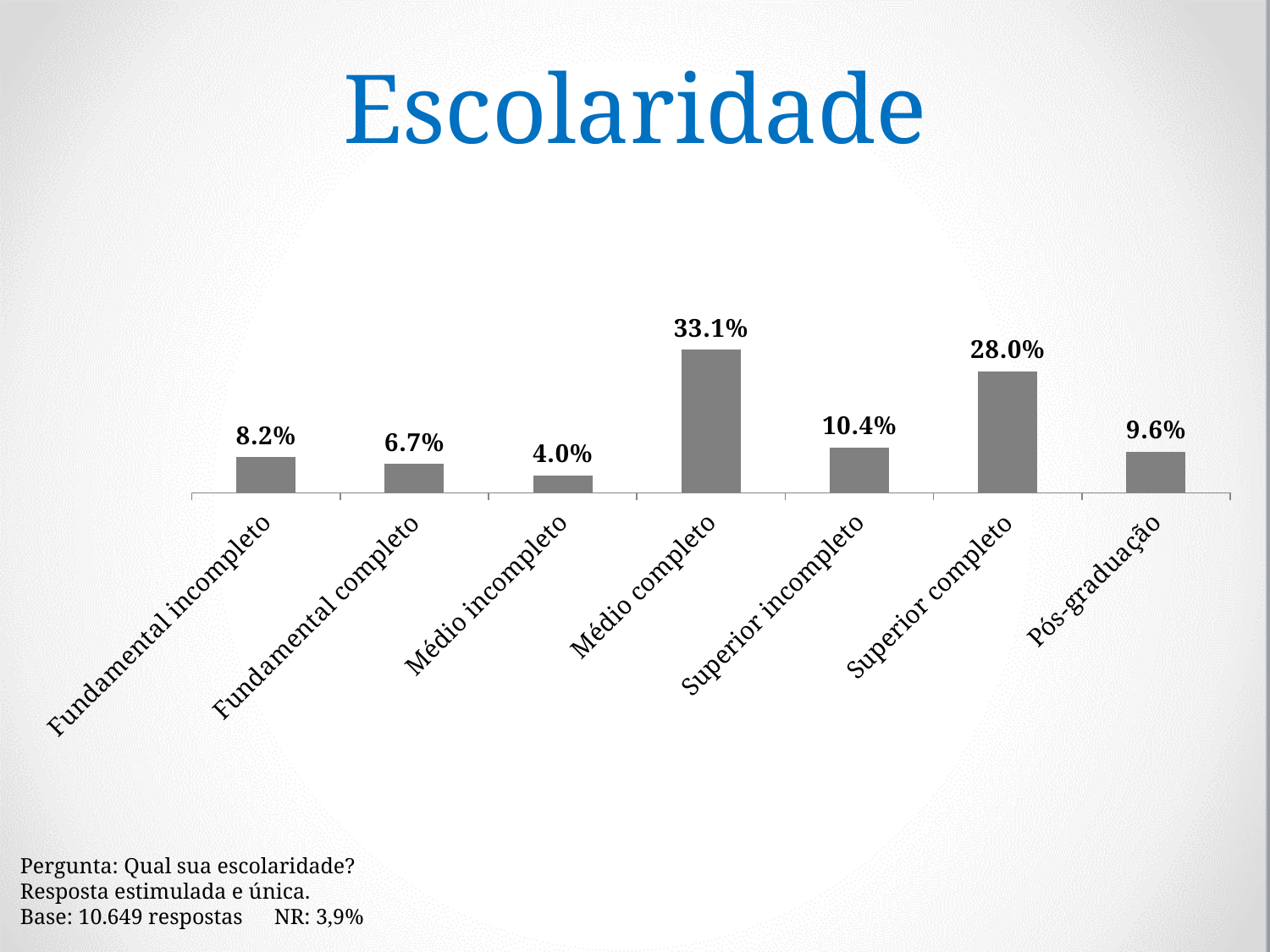
What is the value for Pós-graduação? 9.6% What is the value for Fundamental incompleto? 8.2% What is the title of the slide? Escolaridade Which category has the lowest value? Médio incompleto What is the value for Superior completo? 28.0% Which is larger, Pós-graduação or Fundamental incompleto? Pós-graduação What is the difference between Médio completo and Superior completo? 5.1% What kind of chart is shown on the slide? Bar chart Which category has the highest value? Médio completo How many categories are shown on the x axis? 7 What is the value for Médio completo? 33.1% What is the difference between Superior incompleto and Fundamental completo? 3.7%